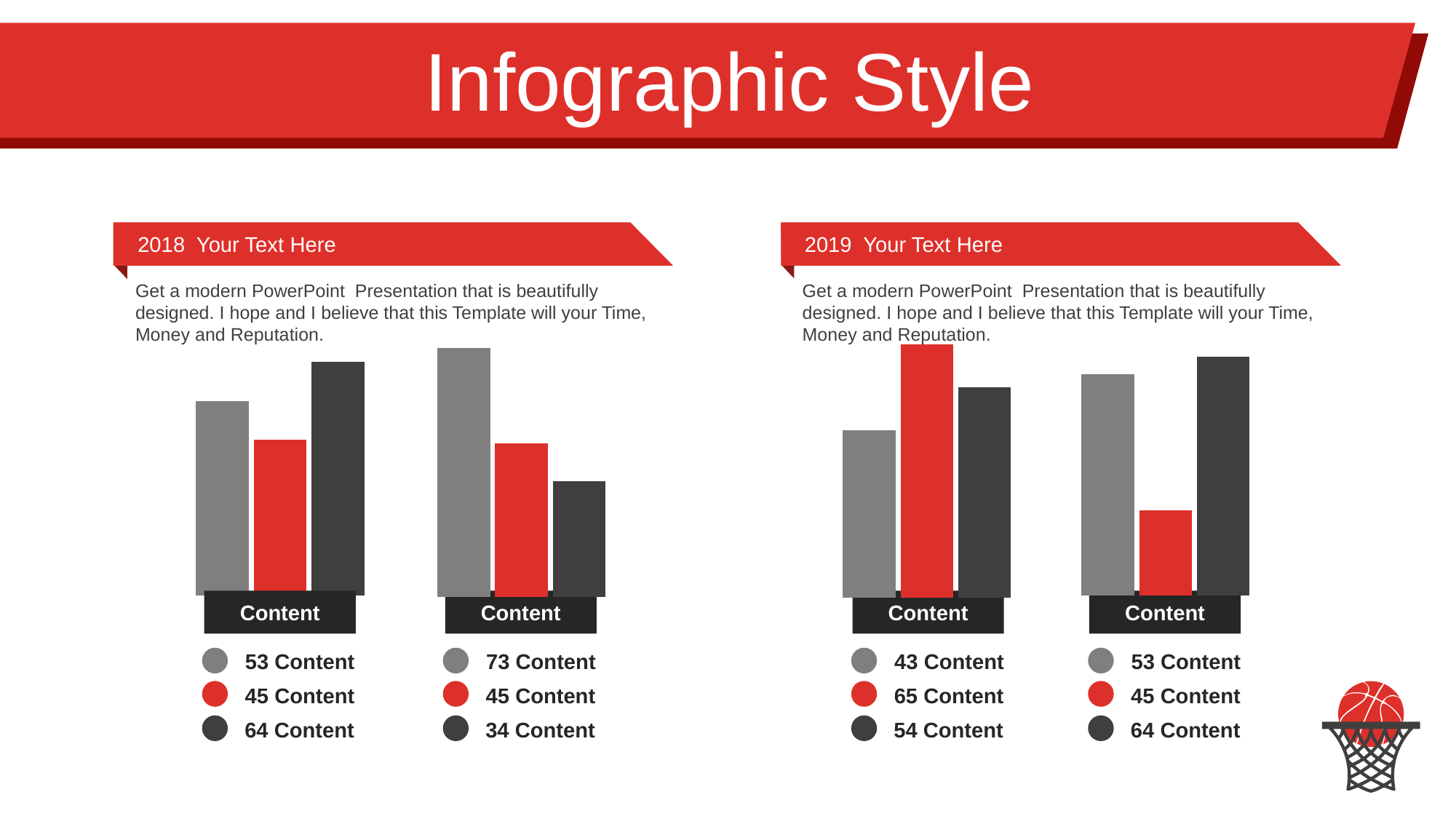
In the left chart under the 2018 heading, which colour bar is the tallest? the dark gray bar (64) In the right chart under the 2018 heading, what is the value of the dark gray bar? 34 In the left chart under the 2019 heading, what is the value of the red bar? 65 How many bars does each chart on the slide contain? 3 How many bar charts are shown on the slide in total? 4 In the right chart under the 2018 heading, what is the difference between the gray bar and the dark gray bar? 39 What type of chart is used in each of the four charts on the slide? bar chart In the right chart under the 2018 heading, which colour bar is the shortest? the dark gray bar (34) In the left chart under the 2019 heading, which colour bar is the tallest? the red bar (65) In the left chart under the 2018 heading, what is the value of the gray bar? 53 In the left chart under the 2019 heading, is the gray bar or the dark gray bar larger? the dark gray bar (54)